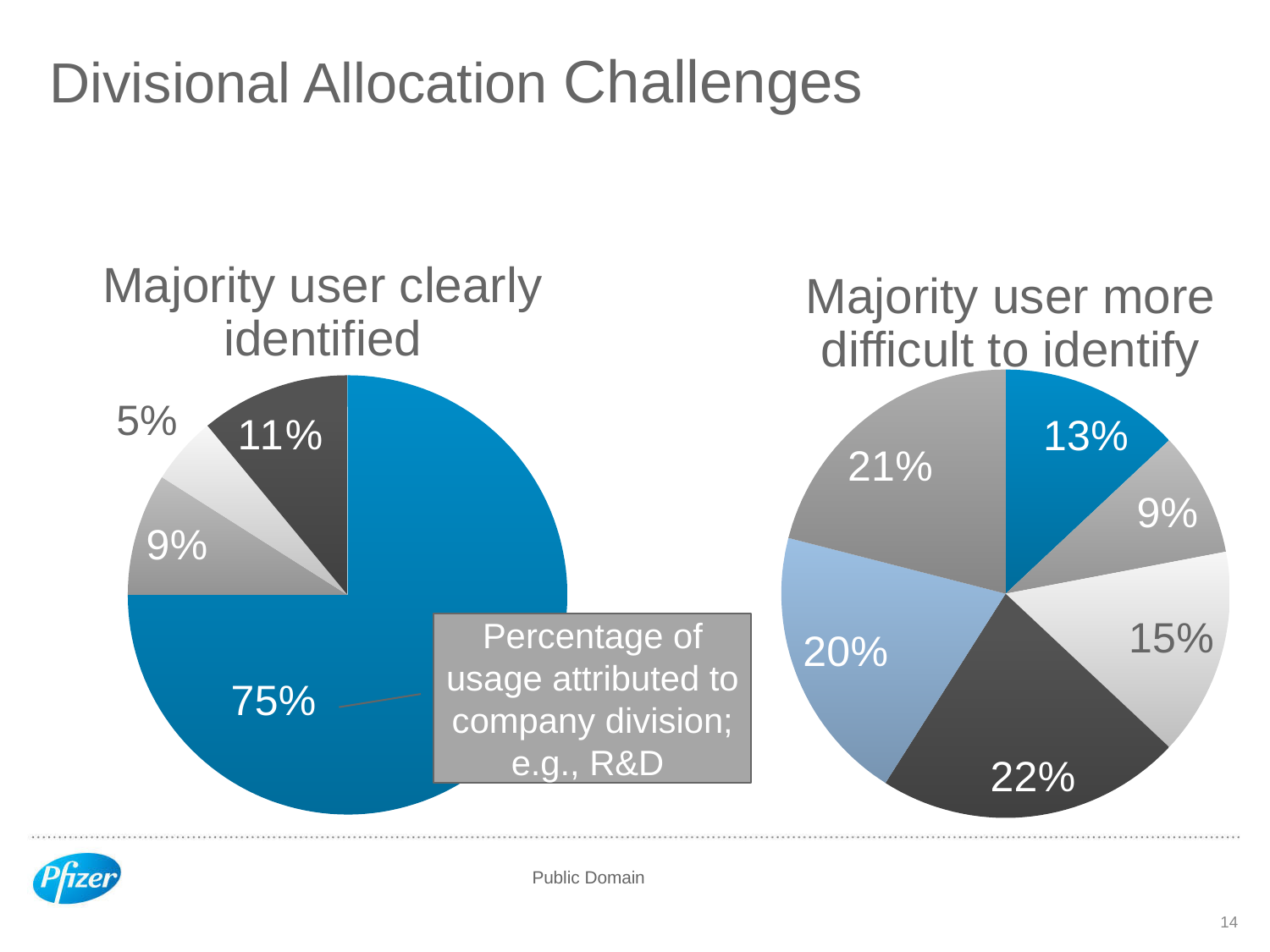
In the "Majority user more difficult to identify" pie chart, what is the value of the smallest slice? 9% Which chart has the larger biggest slice, "Majority user clearly identified" or "Majority user more difficult to identify"? Majority user clearly identified How many slices does the "Majority user clearly identified" pie chart have? 4 What kind of chart is the "Majority user clearly identified" chart? pie chart In the "Majority user clearly identified" pie chart, what is the value of the large blue slice? 75% According to the callout box on the left chart, what do the percentages represent? Percentage of usage attributed to company division; e.g., R&D In the "Majority user clearly identified" pie chart, what is the difference between the largest slice and the smallest slice? 70% In the "Majority user clearly identified" pie chart, what is the value of the smallest slice? 5% In the "Majority user more difficult to identify" pie chart, what is the value of the largest slice? 22% How many slices does the "Majority user more difficult to identify" pie chart have? 6 In the "Majority user more difficult to identify" pie chart, what is the value of the light blue slice? 20% In the "Majority user clearly identified" pie chart, what is the value of the largest slice? 75%